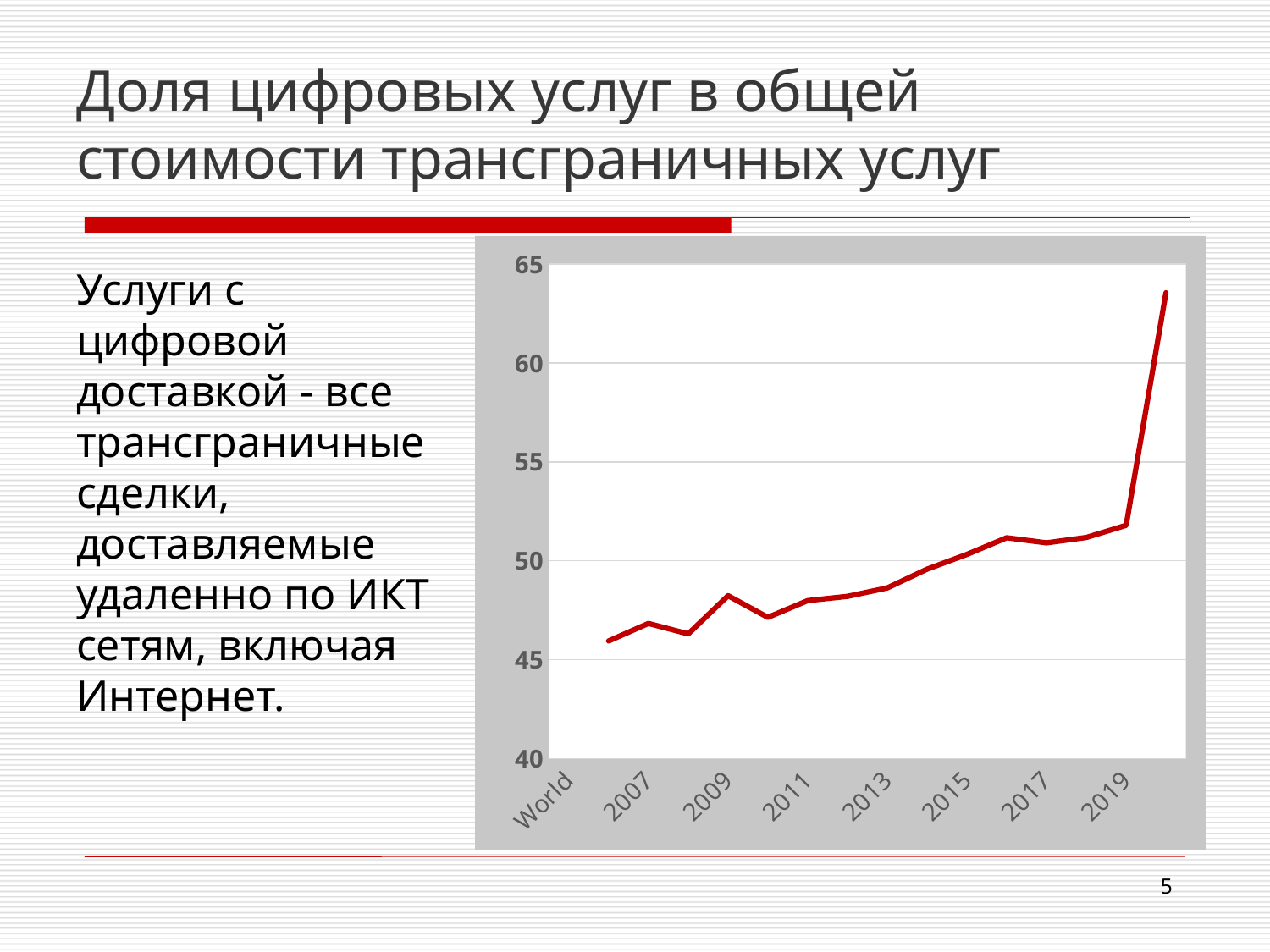
What is the highest value shown on the y axis? 65 Is the value for 2019 greater or less than 50? greater What colour is the line on the chart? red Is the final (rightmost) value on the line greater or less than 60? greater Overall, do the values on the chart rise or fall from left to right along the x axis? rise Is the lowest value on the line greater or less than 45? greater Which is larger, the value for 2007 or the value for 2019? 2019 What kind of chart is shown on the slide? line chart Which is larger, the value for 2007 or the value for 2009? 2009